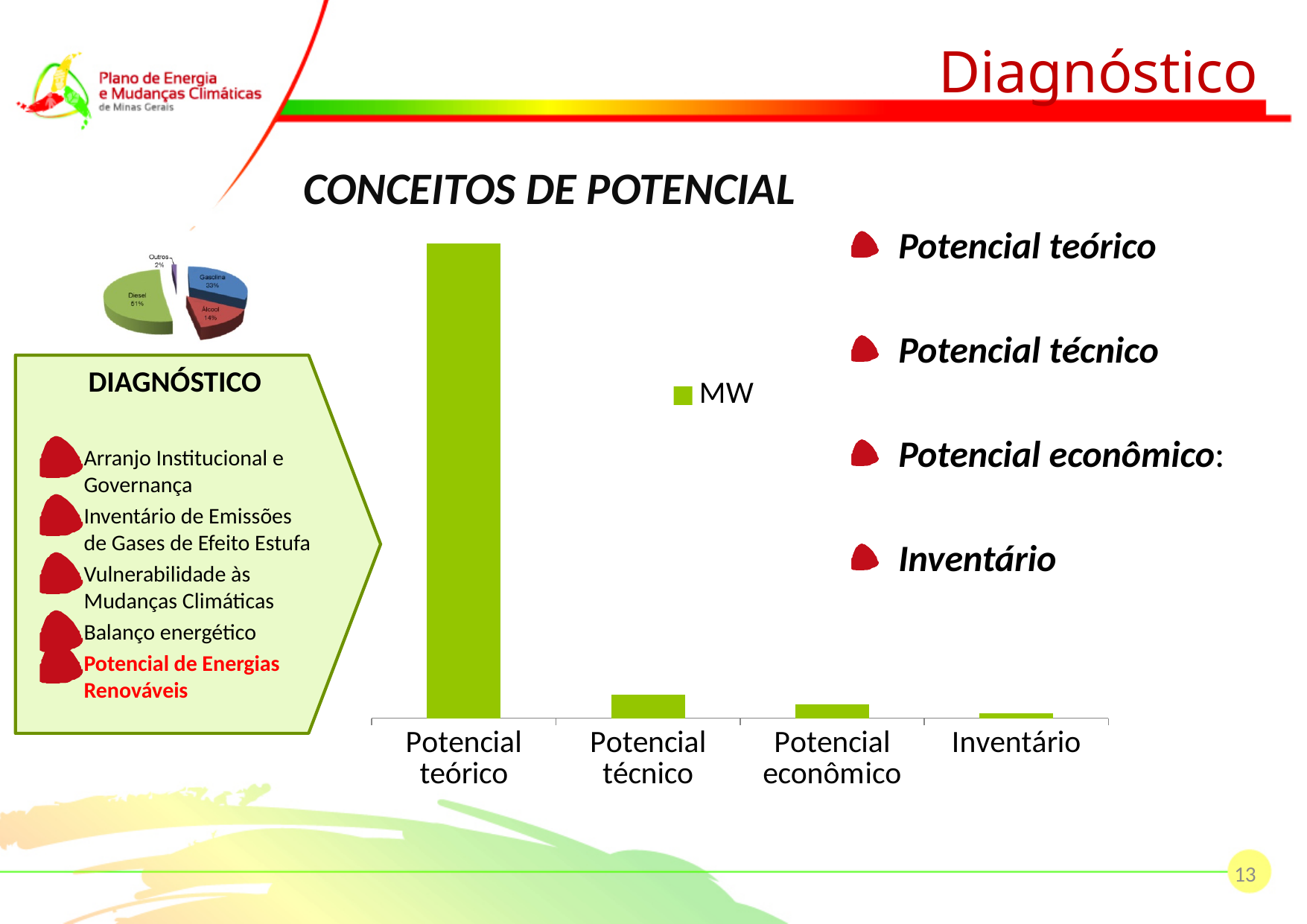
What is the label of the first category on the x axis of the bar chart? Potencial teórico Which category has the highest bar in the bar chart? Potencial teórico Which category has the lowest bar in the bar chart? Inventário In the small pie chart on the left, what share does Diesel have? 51% What kind of chart is the large chart in the centre of the slide? bar chart In the small pie chart on the left, which slice is the largest? Diesel How many categories are shown on the x axis of the bar chart? 4 How many series does the legend of the bar chart list? 1 What is the legend entry of the bar chart? MW In the bar chart, which is larger: Potencial econômico or Inventário? Potencial econômico In the bar chart, which is larger: Potencial técnico or Potencial econômico? Potencial técnico Do the bar values rise or fall from left to right along the x axis of the bar chart? fall